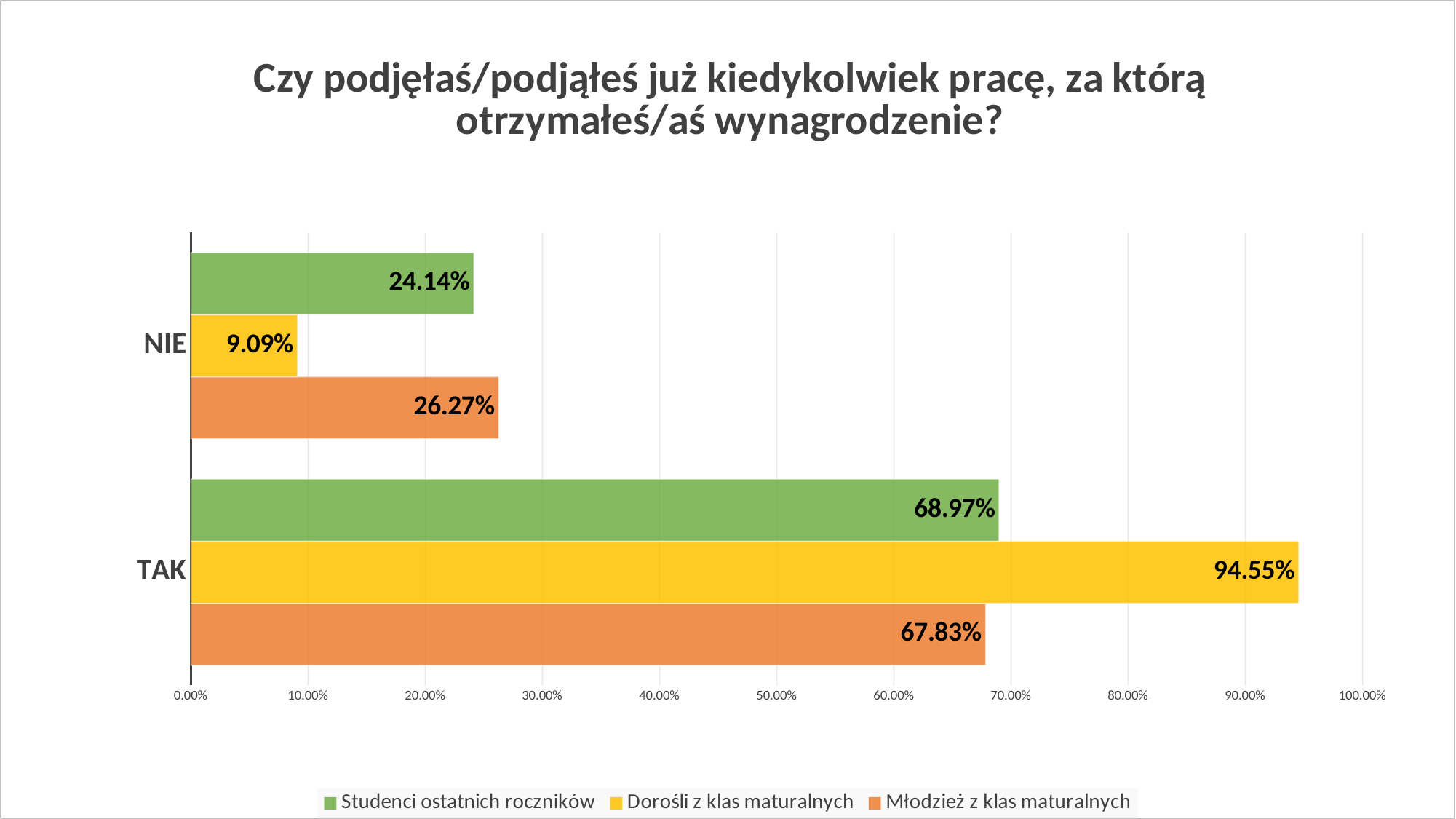
How many categories are shown on the vertical axis? 2 What is the difference between the TAK and NIE values for 'Dorośli z klas maturalnych'? 85.46% Which series has the lowest value in the NIE category? Dorośli z klas maturalnych What is the value for 'Studenci ostatnich roczników' in the NIE category? 24.14% What is the value for 'Młodzież z klas maturalnych' in the TAK category? 67.83% How many series does the legend list? 3 Which is larger in the NIE category: 'Studenci ostatnich roczników' or 'Młodzież z klas maturalnych'? Młodzież z klas maturalnych What is the value for 'Dorośli z klas maturalnych' in the TAK category? 94.55% Is the value for 'Studenci ostatnich roczników' in the TAK category greater or less than 60.00%? greater Which colour represents 'Młodzież z klas maturalnych' in the legend? orange Which series has the highest value in the TAK category? Dorośli z klas maturalnych What kind of chart is shown on the slide? bar chart